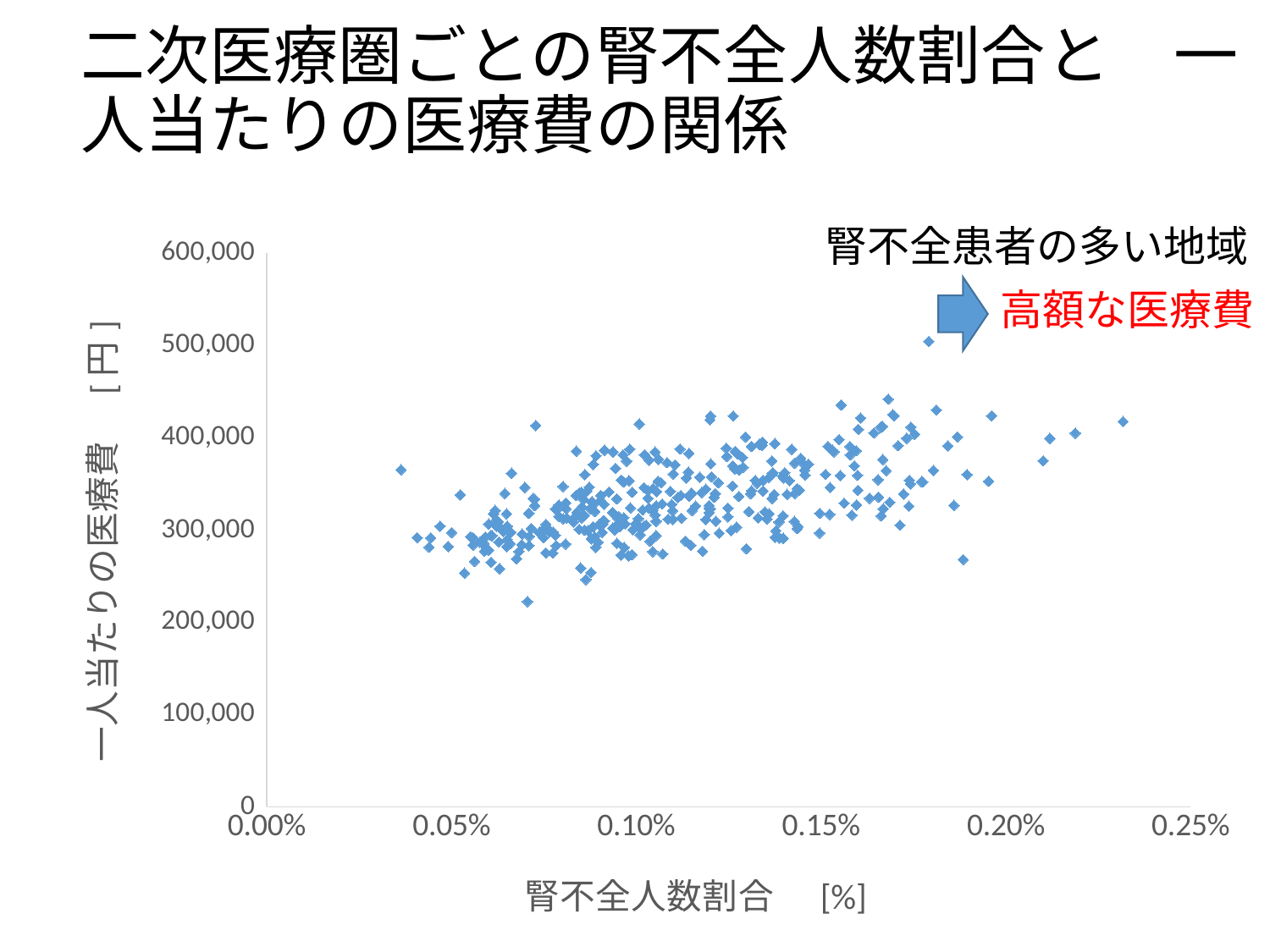
How many data series are plotted in the chart? 1 What is the highest tick value shown on the y axis? 600,000 Is the largest plotted kidney failure ratio greater or less than 0.25%? less What is the highest tick value shown on the x axis? 0.25% Is the highest plotted medical cost value greater or less than 400,000? greater What kind of chart is shown on the slide? scatter plot As the kidney failure ratio (腎不全人数割合) increases along the x axis, do the per-person medical costs generally rise or fall? rise What is the interval between consecutive tick marks on the x axis? 0.05% What is the label of the y axis? 一人当たりの医療費 [円] Is the smallest plotted kidney failure ratio greater or less than 0.05%? less What is the label of the x axis? 腎不全人数割合 [%]